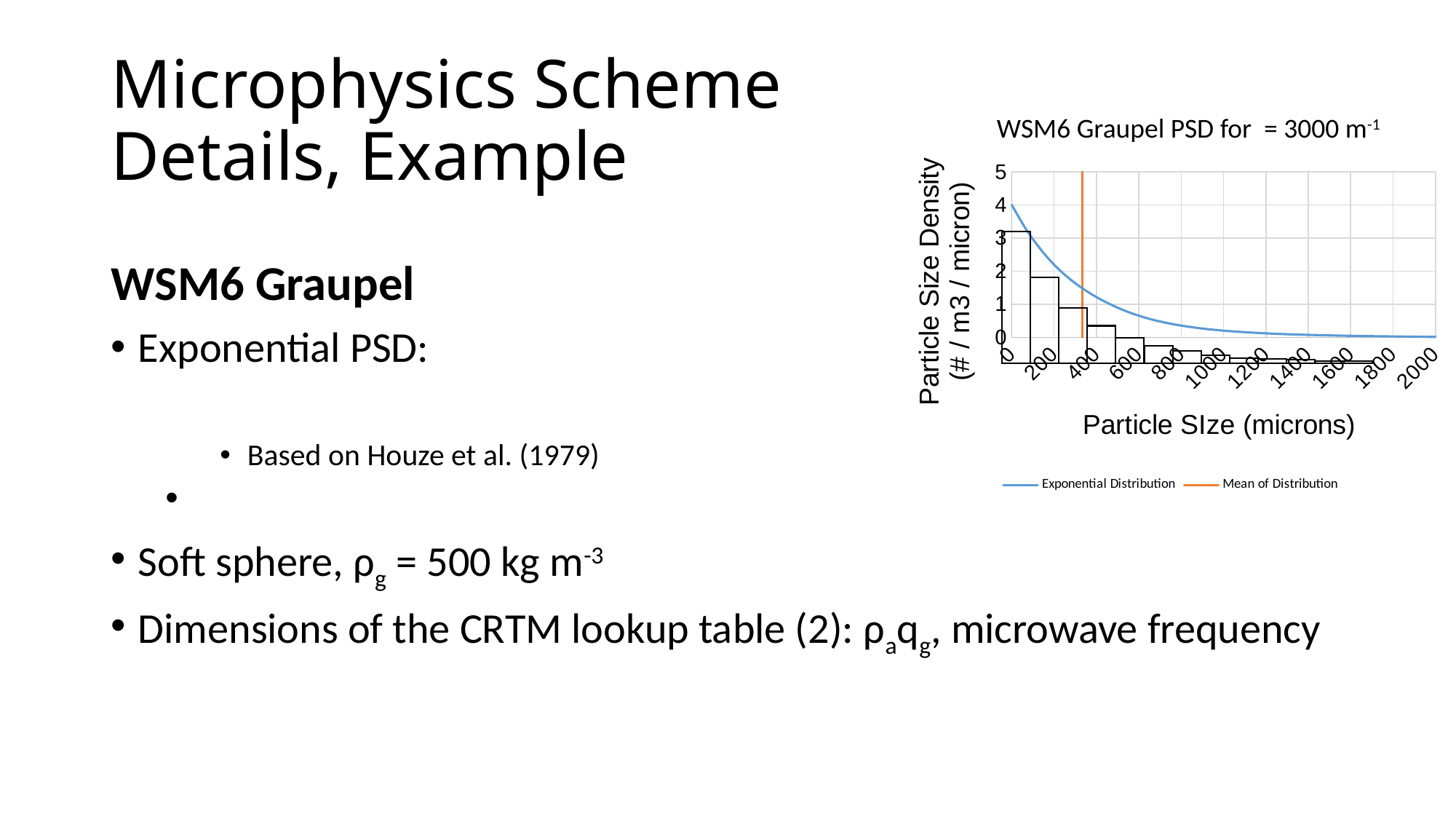
How many series does the chart legend list? 2 What is the label of the x axis of the chart? Particle SIze (microns) Does the Exponential Distribution rise or fall as particle size increases along the x axis? fall Which is larger, the Exponential Distribution value at 200 microns or at 800 microns? 200 microns What are the two entries in the chart legend? Exponential Distribution, Mean of Distribution Is the Exponential Distribution value at a particle size of 0 microns greater or less than 3? greater What is the highest value shown on the y axis of the chart? 5 Is the Exponential Distribution value at a particle size of 2000 microns greater or less than 1? less Is the Mean of Distribution located at a particle size greater or less than 600 microns? less